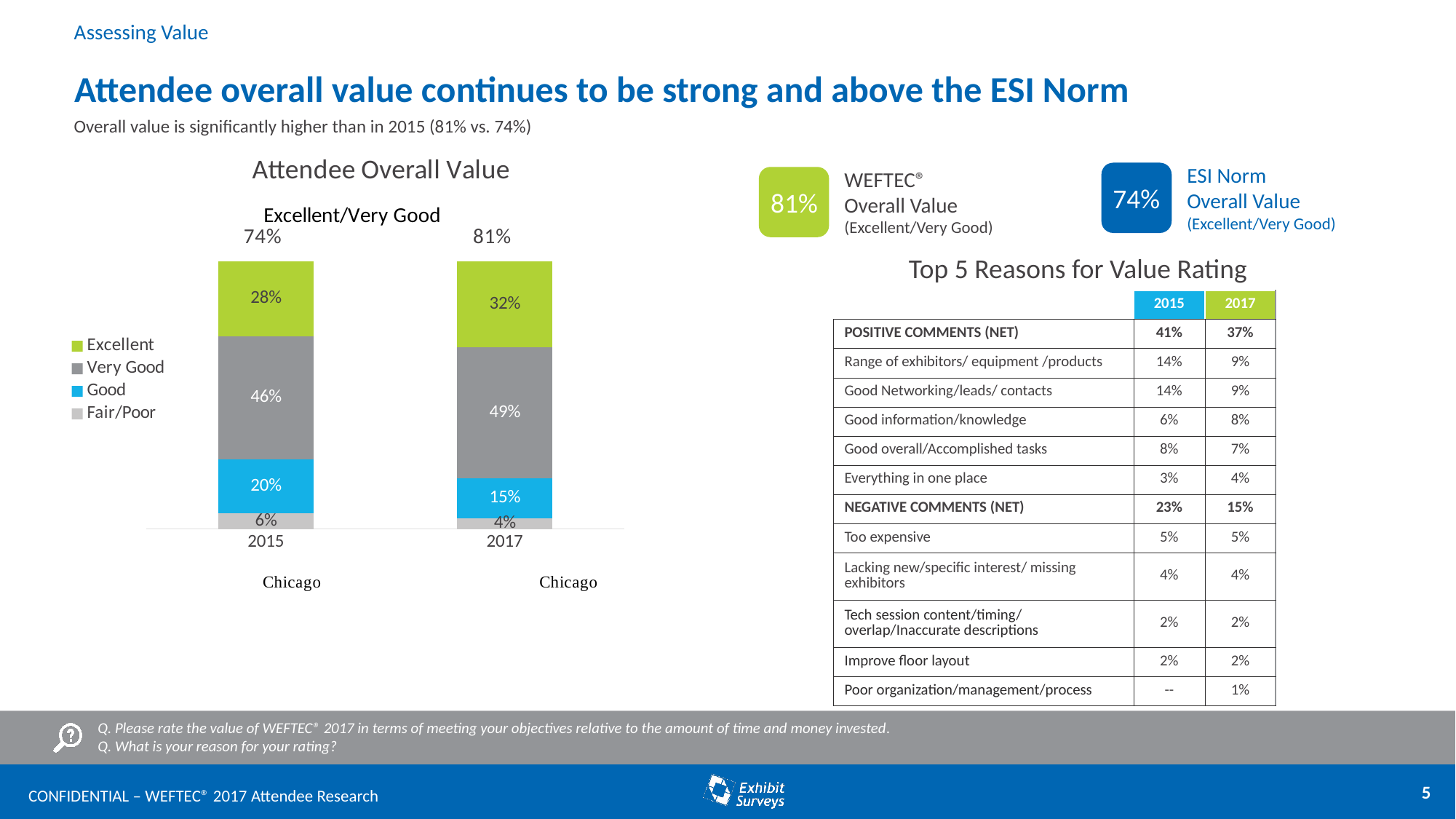
How many series does the legend of the Attendee Overall Value chart list? 4 What type of chart is the Attendee Overall Value chart? Stacked bar chart In the Attendee Overall Value chart, what is the Very Good value for 2015? 46% In the Attendee Overall Value chart, what is the Excellent/Very Good total shown above the 2017 bar? 81% In the Attendee Overall Value chart, what colour represents the Excellent series? Green In the Attendee Overall Value chart, which year has the higher Excellent value? 2017 In the Attendee Overall Value chart, what is the Fair/Poor value for 2015? 6% In the Attendee Overall Value chart, what is the difference between the Very Good values for 2017 and 2015? 3% In the Attendee Overall Value chart, what is the Good value for 2017? 15% How many bars are in the Attendee Overall Value chart? 2 In the Attendee Overall Value chart, which year has the larger Good value, 2015 or 2017? 2015 In the Attendee Overall Value chart, what is the Excellent value for 2017? 32%